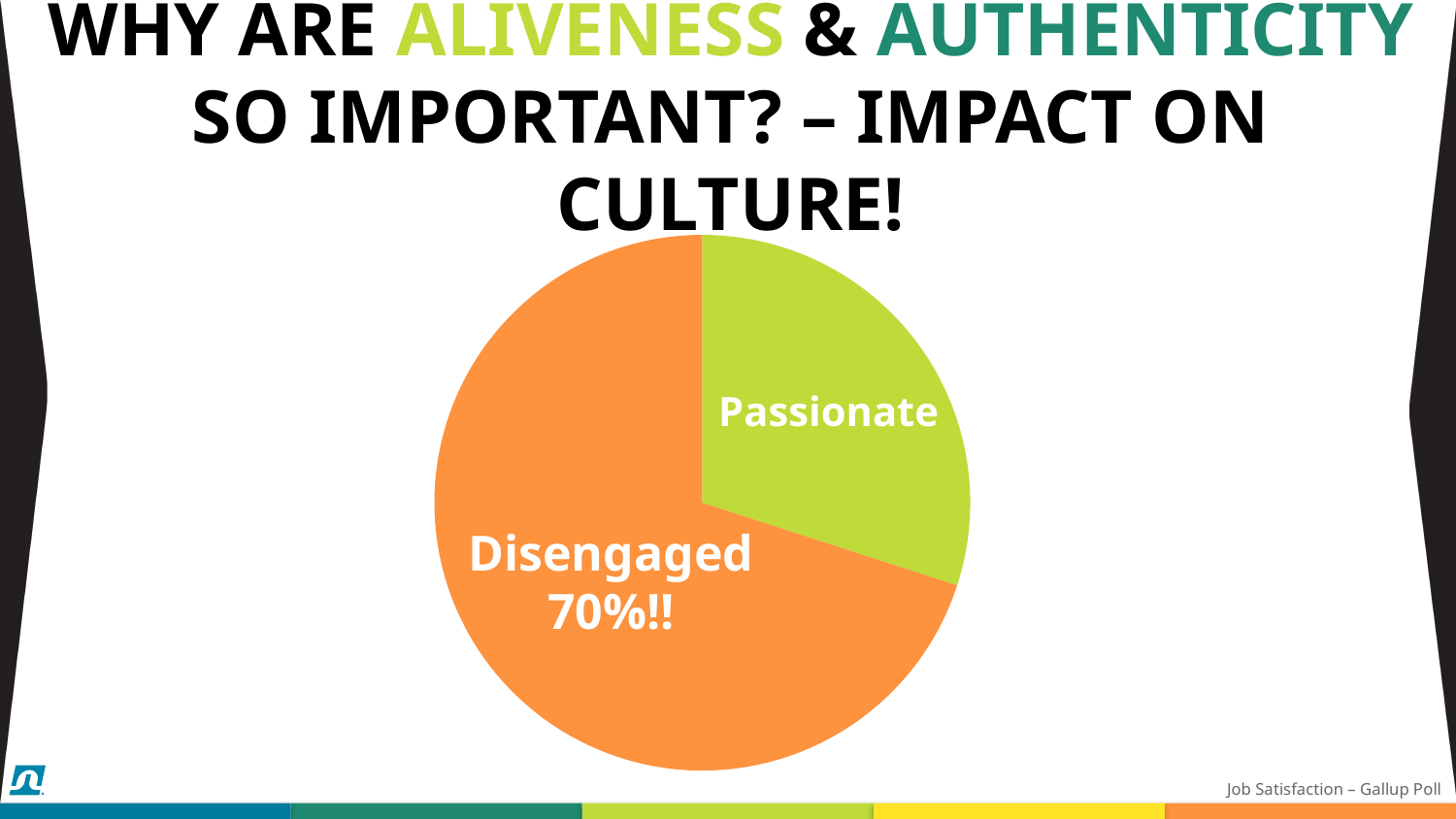
What share of the pie does the Disengaged slice represent? 70% What kind of chart is shown on the slide? pie chart How many slices does the pie chart have? 2 What source is cited for the pie chart data at the bottom right of the slide? Job Satisfaction – Gallup Poll Is the Disengaged share greater or less than 50%? greater What colour is the Passionate slice? green Which slice of the pie chart is the largest? Disengaged Which slice of the pie chart is the smallest? Passionate Which slice is larger, Passionate or Disengaged? Disengaged What percentage is shown for the Disengaged slice? 70%